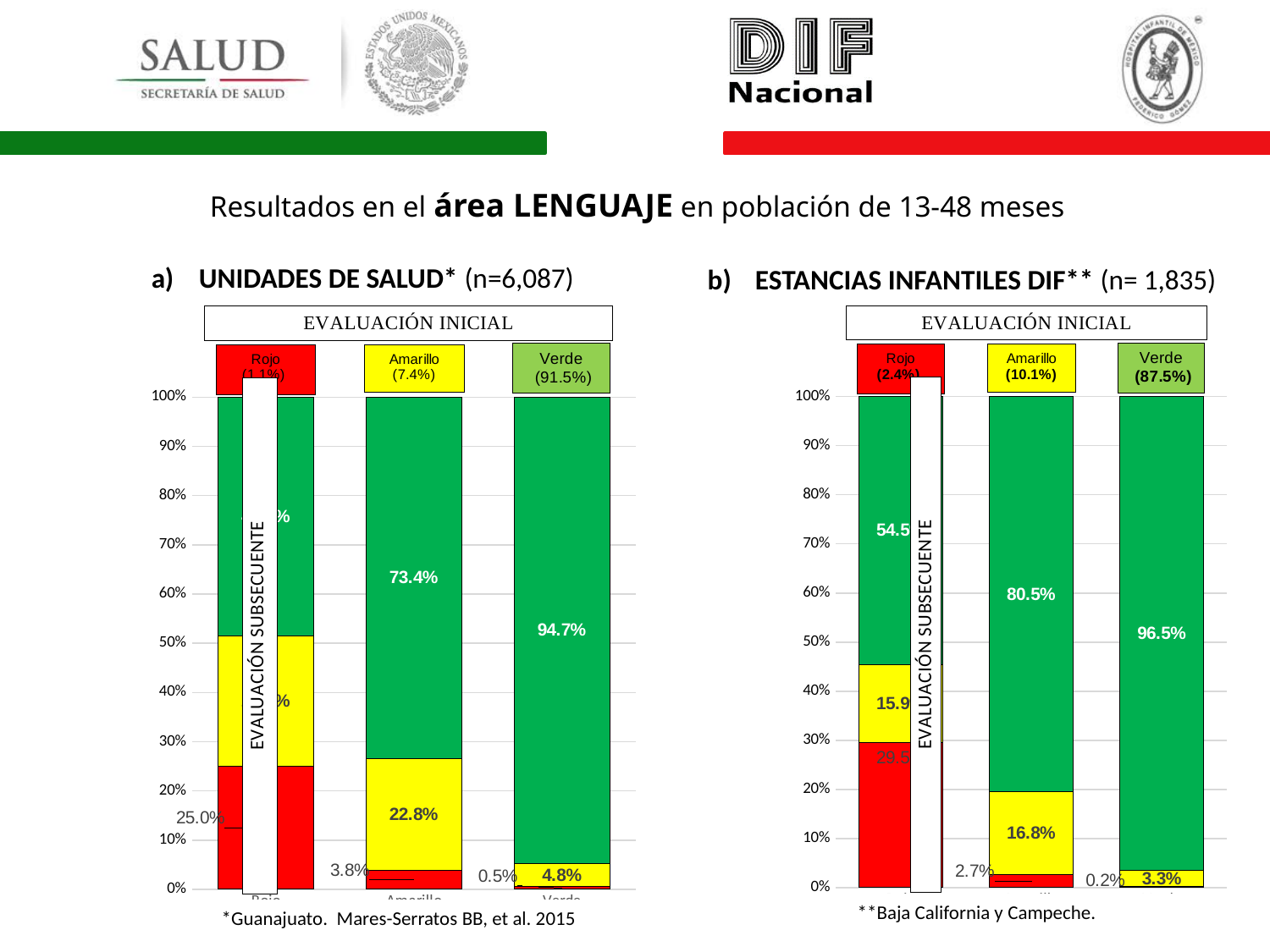
In the right chart (ESTANCIAS INFANTILES DIF), what is the green segment value for the Amarillo bar? 80.5% In the right chart (ESTANCIAS INFANTILES DIF), what is the yellow segment value for the Verde bar? 3.3% In the left chart (UNIDADES DE SALUD), what is the yellow segment value for the Amarillo bar? 22.8% In the left chart (UNIDADES DE SALUD), what is the green segment value for the Verde bar? 94.7% How many bars (initial evaluation categories) does the right chart (ESTANCIAS INFANTILES DIF) show? 3 In the right chart (ESTANCIAS INFANTILES DIF), what percentage is shown in the Verde header label for the initial evaluation? 87.5% In the right chart (ESTANCIAS INFANTILES DIF), which is larger: the yellow segment of the Amarillo bar or the yellow segment of the Verde bar? Amarillo bar (16.8%) In the left chart (UNIDADES DE SALUD), what is the red segment value for the Verde bar? 0.5% In the right chart (ESTANCIAS INFANTILES DIF), what is the red segment value for the Amarillo bar? 2.7% In the left chart (UNIDADES DE SALUD), what is the difference between the green segment of the Verde bar and the green segment of the Amarillo bar? 21.3% What kind of chart is shown on the left (UNIDADES DE SALUD)? Stacked bar chart In the left chart (UNIDADES DE SALUD), what is the green segment value for the Amarillo bar? 73.4%